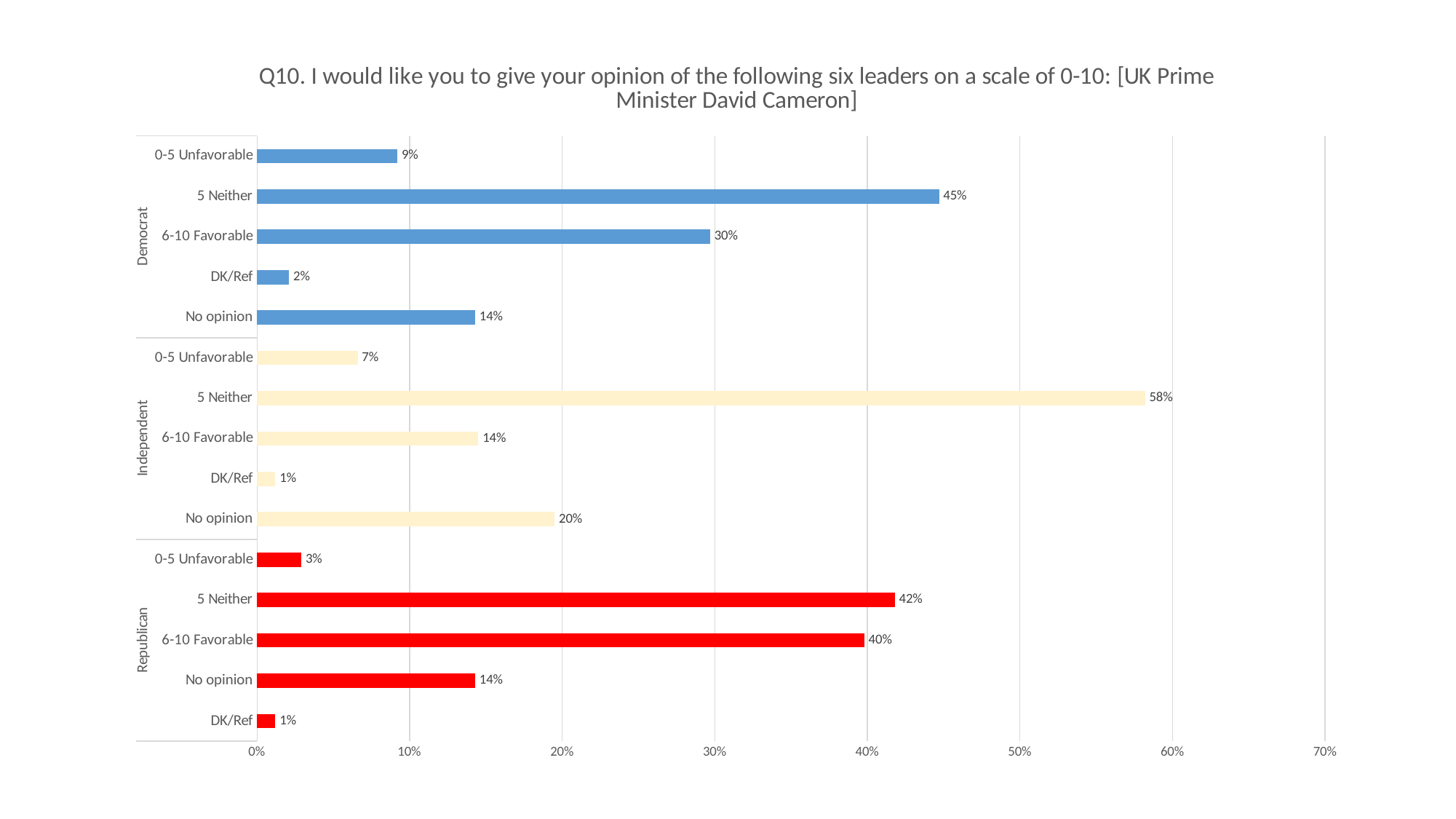
What percentage of Republicans rated David Cameron 0-5 Unfavorable? 3% Which response category has the highest value among Independents? 5 Neither What kind of chart is shown on the slide? Bar chart Which is larger: the Democrat 6-10 Favorable value or the Republican 6-10 Favorable value? Republican 6-10 Favorable What colour are the bars for the Republican group? Red What percentage of Democrats rated David Cameron 5 Neither? 45% How many bars are plotted on the chart in total? 15 Which response category has the lowest value among Democrats? DK/Ref What is the difference between the Independent No opinion value and the Democrat No opinion value? 6% What is the difference between the Republican 5 Neither value and the Republican 6-10 Favorable value? 2% What percentage of Independents rated David Cameron 6-10 Favorable? 14% Is the Independent 5 Neither value greater or less than 50%? greater